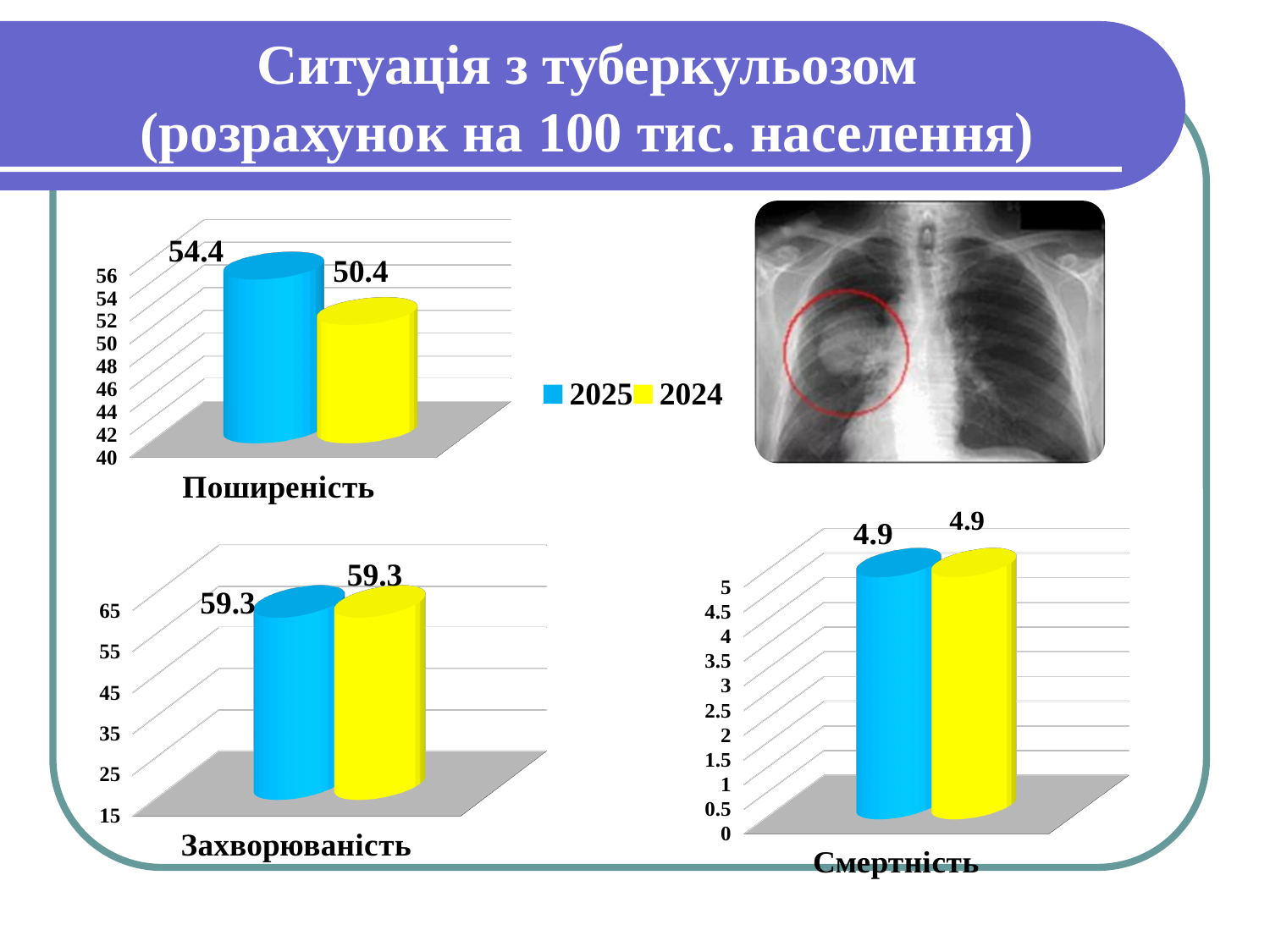
In the "Поширеність" chart, which year has the higher value, 2025 or 2024? 2025 In the "Поширеність" chart, what is the difference between the 2025 and 2024 values? 4.0 In the "Смертність" chart, what is the value for 2025? 4.9 In the "Смертність" chart, what is the difference between the 2025 and 2024 values? 0.0 In the "Поширеність" chart, what is the value for 2025? 54.4 In the "Захворюваність" chart, what is the value for 2025? 59.3 How many series does the legend on the slide list? 2 In the "Смертність" chart, what is the value for 2024? 4.9 In the "Захворюваність" chart, is the value for 2025 greater or less than 55? greater What kind of chart is the "Поширеність" chart? Bar chart In the "Поширеність" chart, what is the value for 2024? 50.4 In the "Захворюваність" chart, what is the value for 2024? 59.3